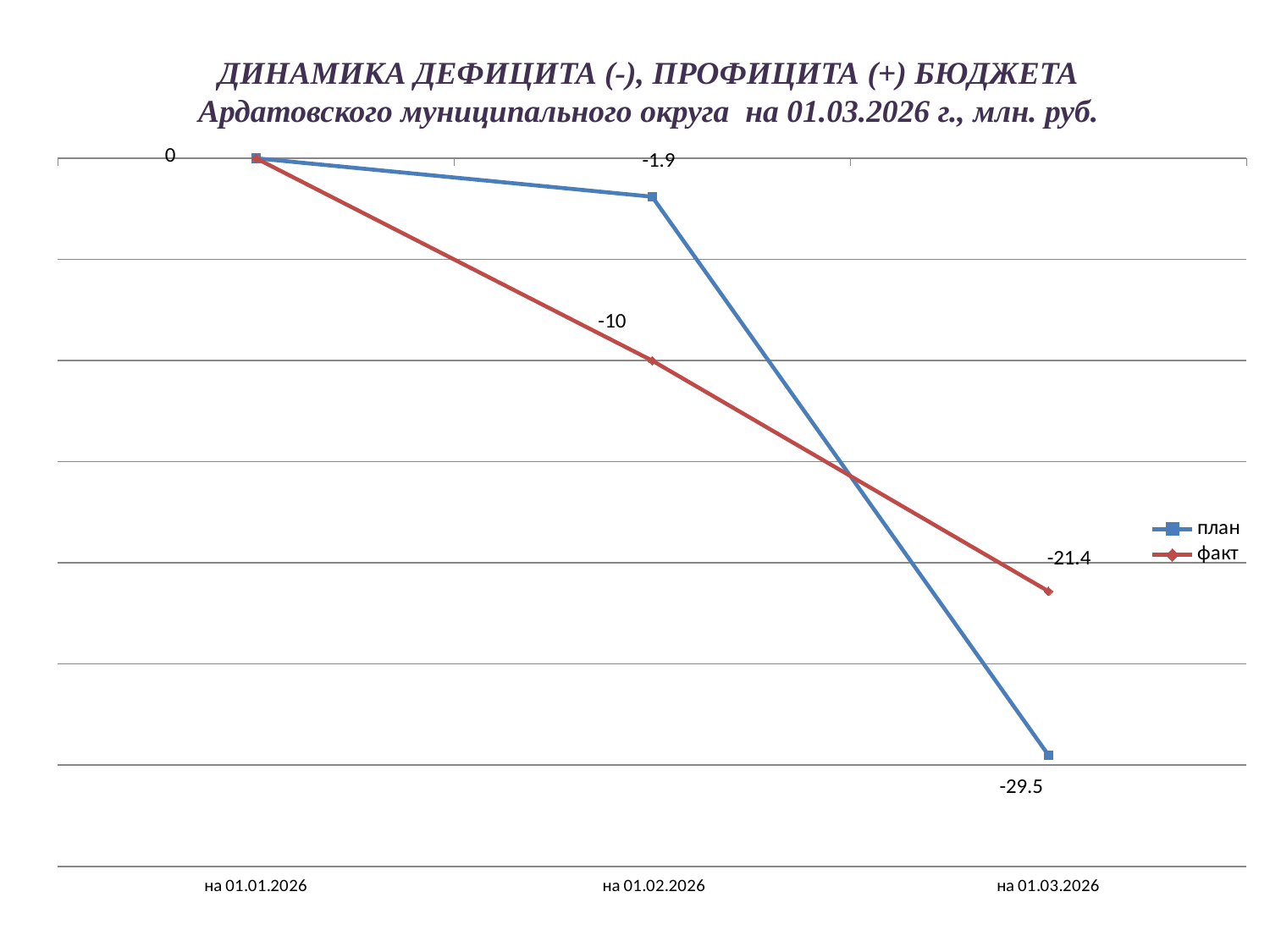
What is the value of the план series on 01.03.2026? -29.5 What is the value of the факт series on 01.03.2026? -21.4 How many dates are shown along the x axis? 3 Which series is drawn in red? факт What is the value of the план series on 01.02.2026? -1.9 Which series has the lower value on 01.03.2026, план or факт? план What is the value shown for 01.01.2026? 0 What is the value of the факт series on 01.02.2026? -10 How many series does the legend list? 2 What is the difference between the план and факт values on 01.03.2026? 8.1 What type of chart is shown on the slide? line chart Do the values of the план series rise or fall from 01.01.2026 to 01.03.2026? fall